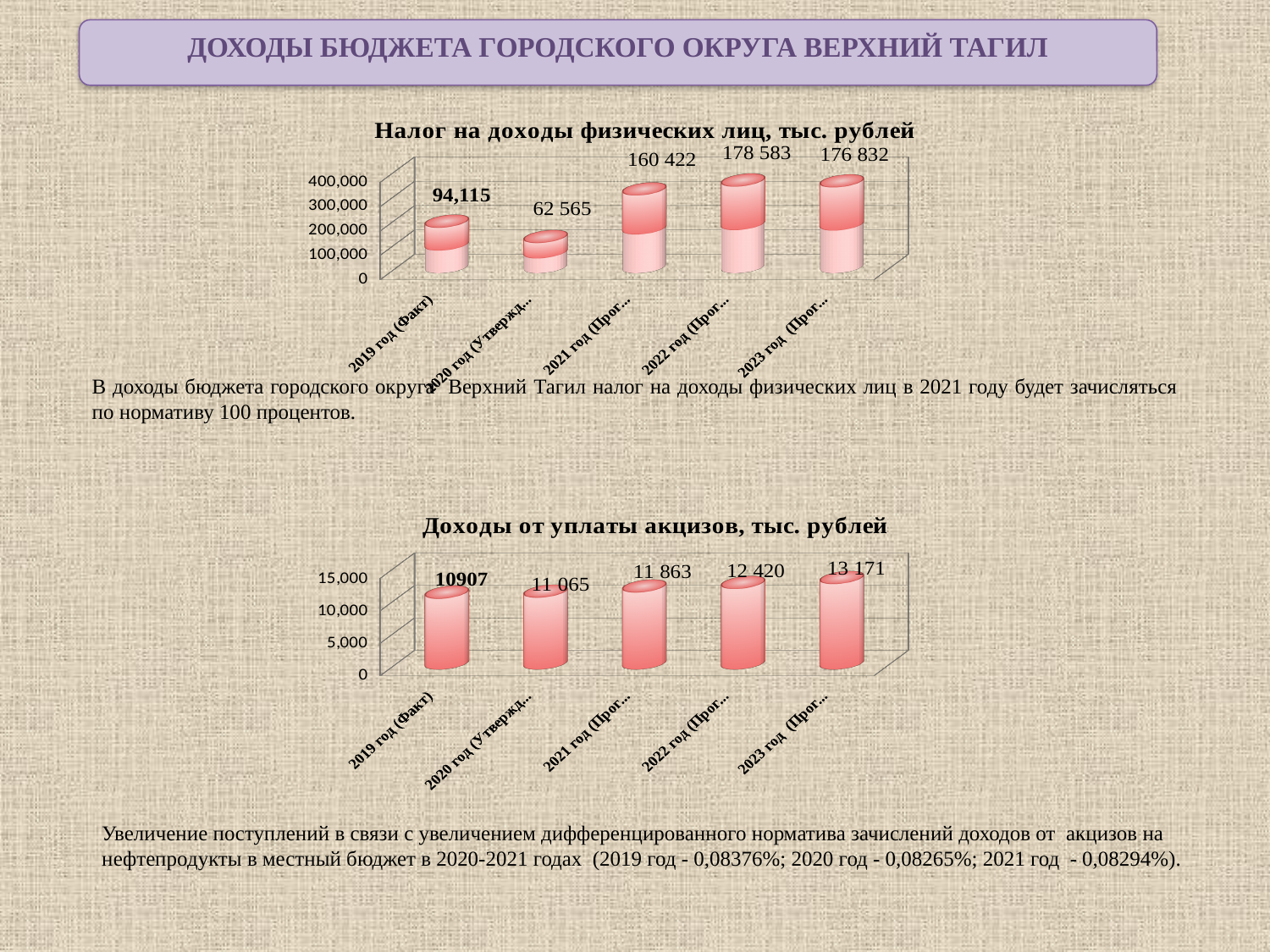
In the chart titled "Доходы от уплаты акцизов, тыс. рублей", what is the difference between the values for 2023 год and 2022 год? 751 What is the title of the top chart on the slide? Налог на доходы физических лиц, тыс. рублей In the chart titled "Налог на доходы физических лиц, тыс. рублей", which is larger: the value for 2021 год or the value for 2020 год? 2021 год In the chart titled "Налог на доходы физических лиц, тыс. рублей", what is the value for 2019 год (Факт)? 94,115 What kind of chart is the chart titled "Доходы от уплаты акцизов, тыс. рублей"? bar chart In the chart titled "Налог на доходы физических лиц, тыс. рублей", which category has the lowest value? 2020 год (Утвержд...) In the chart titled "Доходы от уплаты акцизов, тыс. рублей", what is the value for 2019 год (Факт)? 10907 In the chart titled "Налог на доходы физических лиц, тыс. рублей", how many bars are plotted? 5 In the chart titled "Налог на доходы физических лиц, тыс. рублей", which category has the highest value? 2022 год (Прог...) In the chart titled "Доходы от уплаты акцизов, тыс. рублей", what is the value for 2023 год? 13 171 In the chart titled "Налог на доходы физических лиц, тыс. рублей", what is the value for 2022 год? 178 583 In the chart titled "Доходы от уплаты акцизов, тыс. рублей", do the values rise or fall from 2019 to 2023? rise